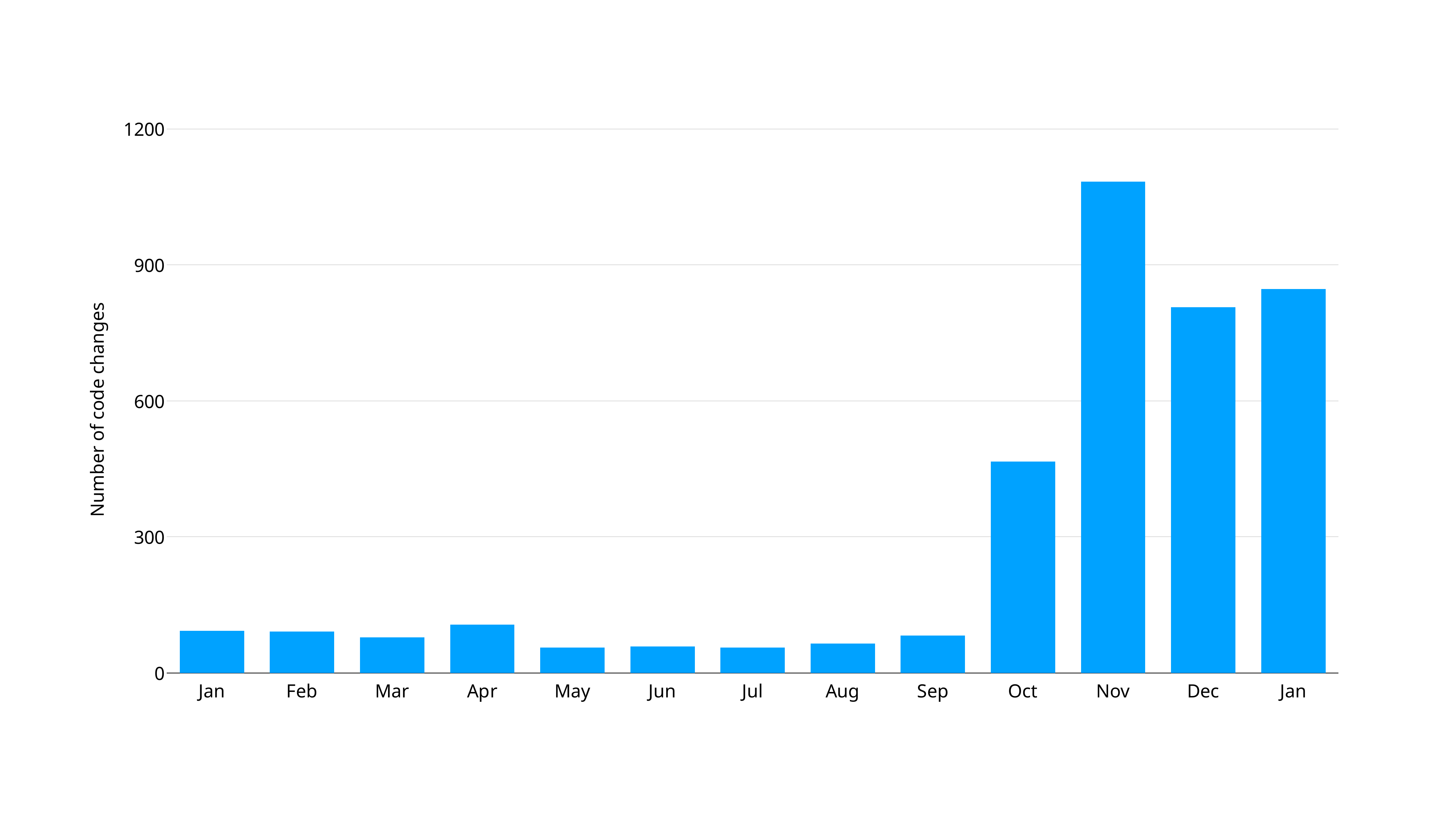
Is the value for Nov greater or less than 900? greater What kind of chart is shown on the slide? bar chart Which month has the highest number of code changes? Nov Is the value for Apr greater or less than 300? less Is the value for Oct greater or less than 300? greater What is the label on the vertical axis? Number of code changes Which is larger, the value for Sep or the value for Oct? Oct How many bars (categories) are plotted on the chart? 13 Which is larger, the value for Nov or the value for Dec? Nov Do the values rise or fall from Sep to Nov? rise